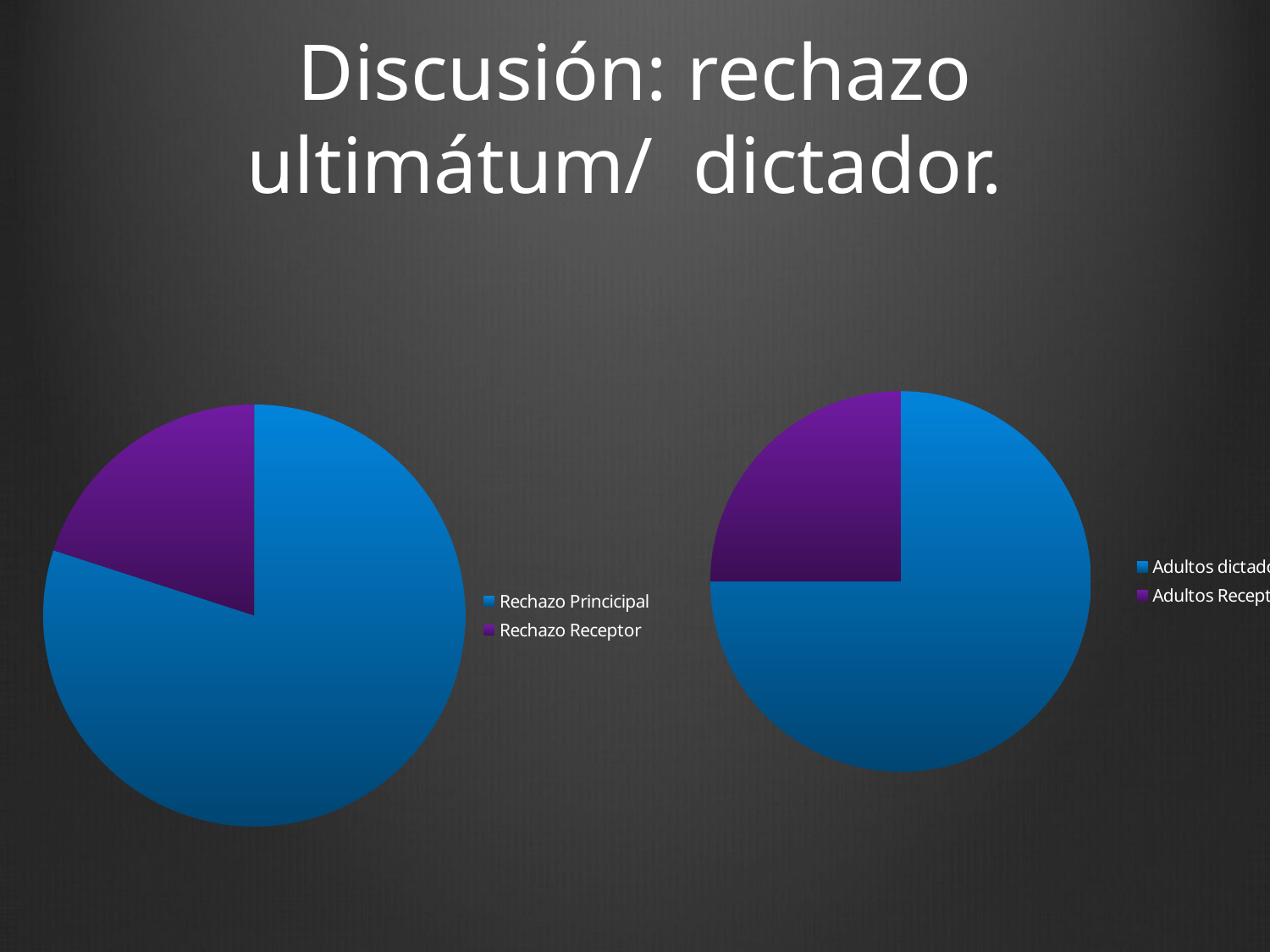
How many slices does the right pie chart have? 2 In the right pie chart, which slice is larger: the blue slice or the purple slice? The blue slice In the left pie chart, what colour is the Rechazo Receptor slice? Purple What kind of chart is the chart on the right of the slide? Pie chart In the left pie chart, which category has the smallest slice? Rechazo Receptor What kind of chart is the chart on the left of the slide? Pie chart In the left pie chart, which category has the largest slice? Rechazo Princicipal In the left pie chart, which slice is larger: Rechazo Princicipal or Rechazo Receptor? Rechazo Princicipal How many entries does the legend of the left pie chart list? 2 What is the title of the slide containing the two pie charts? Discusión: rechazo ultimátum/ dictador. How many slices does the left pie chart have? 2